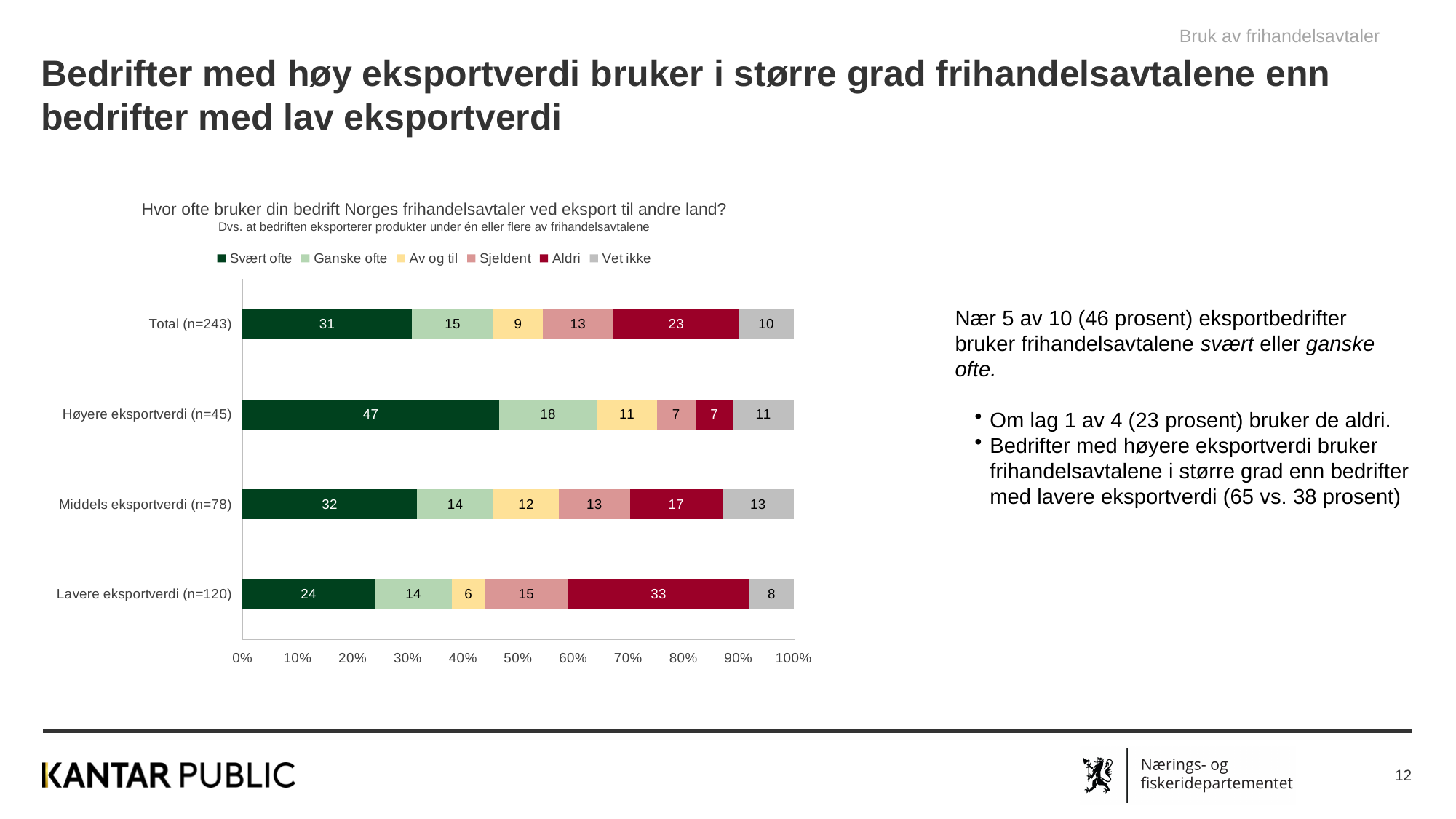
How many series does the legend list? 6 What is the difference between the "Svært ofte" values for "Høyere eksportverdi (n=45)" and "Lavere eksportverdi (n=120)"? 23 Which category has the lowest value for "Av og til"? Lavere eksportverdi (n=120) What is the first entry in the chart's legend? Svært ofte Which has the larger "Aldri" value: "Middels eksportverdi (n=78)" or "Lavere eksportverdi (n=120)"? Lavere eksportverdi (n=120) What is the value for "Aldri" in the "Lavere eksportverdi (n=120)" bar? 33 How many categories (bars) are shown in the chart? 4 Which category has the highest value for "Svært ofte"? Høyere eksportverdi (n=45) What is the value for "Vet ikke" in the "Total (n=243)" bar? 10 What kind of chart is shown on the slide? Stacked bar chart What is the difference between the "Aldri" values for "Total (n=243)" and "Høyere eksportverdi (n=45)"? 16 What is the value for "Svært ofte" in the "Høyere eksportverdi (n=45)" bar? 47